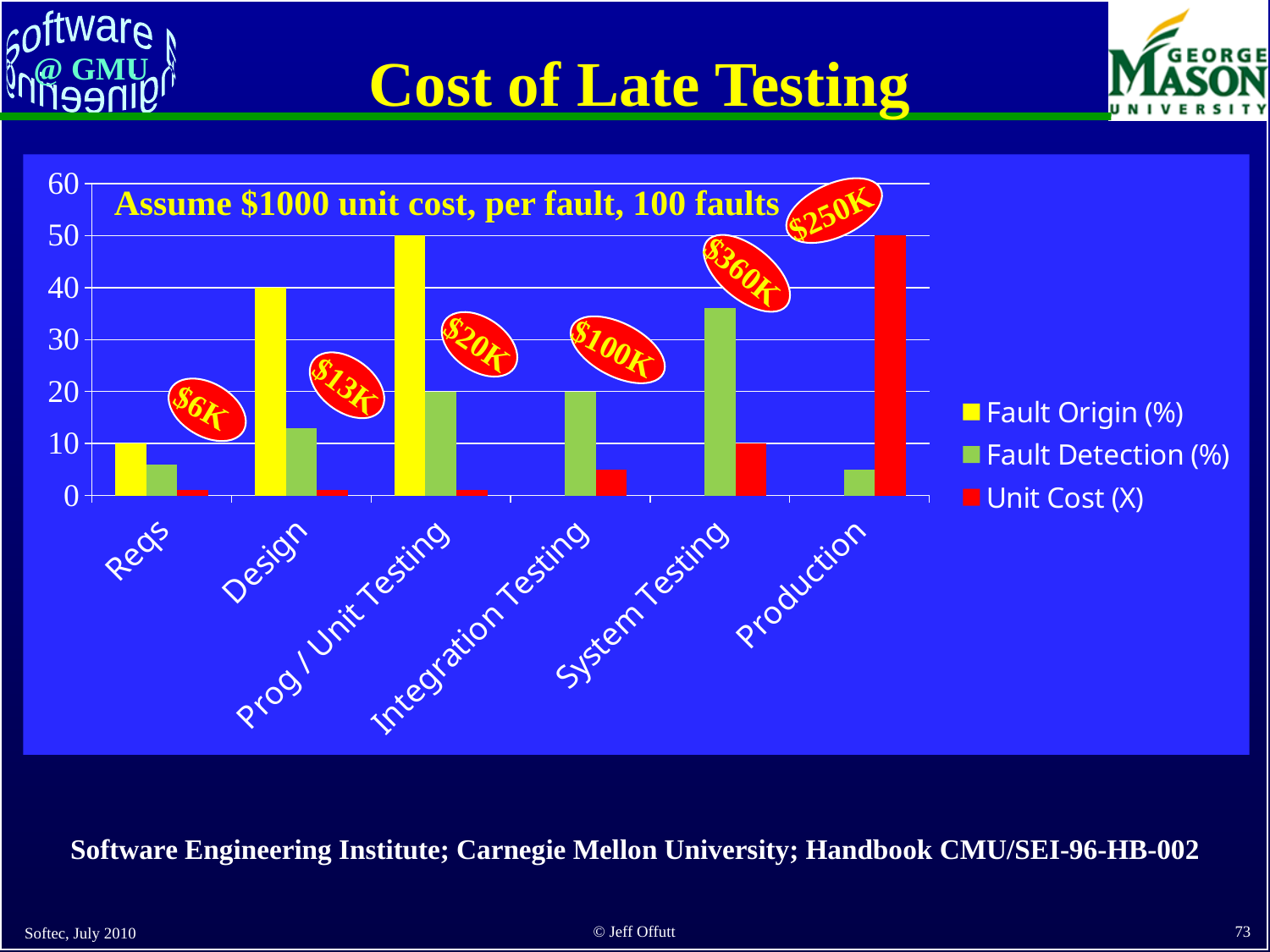
Which category has the highest Fault Origin (%) value? Prog / Unit Testing What is the Fault Origin (%) value for Prog / Unit Testing? 50 What is the Fault Origin (%) value for Design? 40 What is the Unit Cost (X) value for System Testing? 10 Is the Fault Detection (%) value for System Testing greater or less than 30? greater What kind of chart is shown on the slide? bar chart What is the difference between the Fault Origin (%) value for Prog / Unit Testing and the Fault Origin (%) value for Reqs? 40 How many categories are shown on the x axis? 6 How many series does the legend list? 3 Which category has the highest Unit Cost (X) value? Production What is the Unit Cost (X) value for Production? 50 Which is larger, the Fault Detection (%) value for Design or the Fault Detection (%) value for System Testing? System Testing